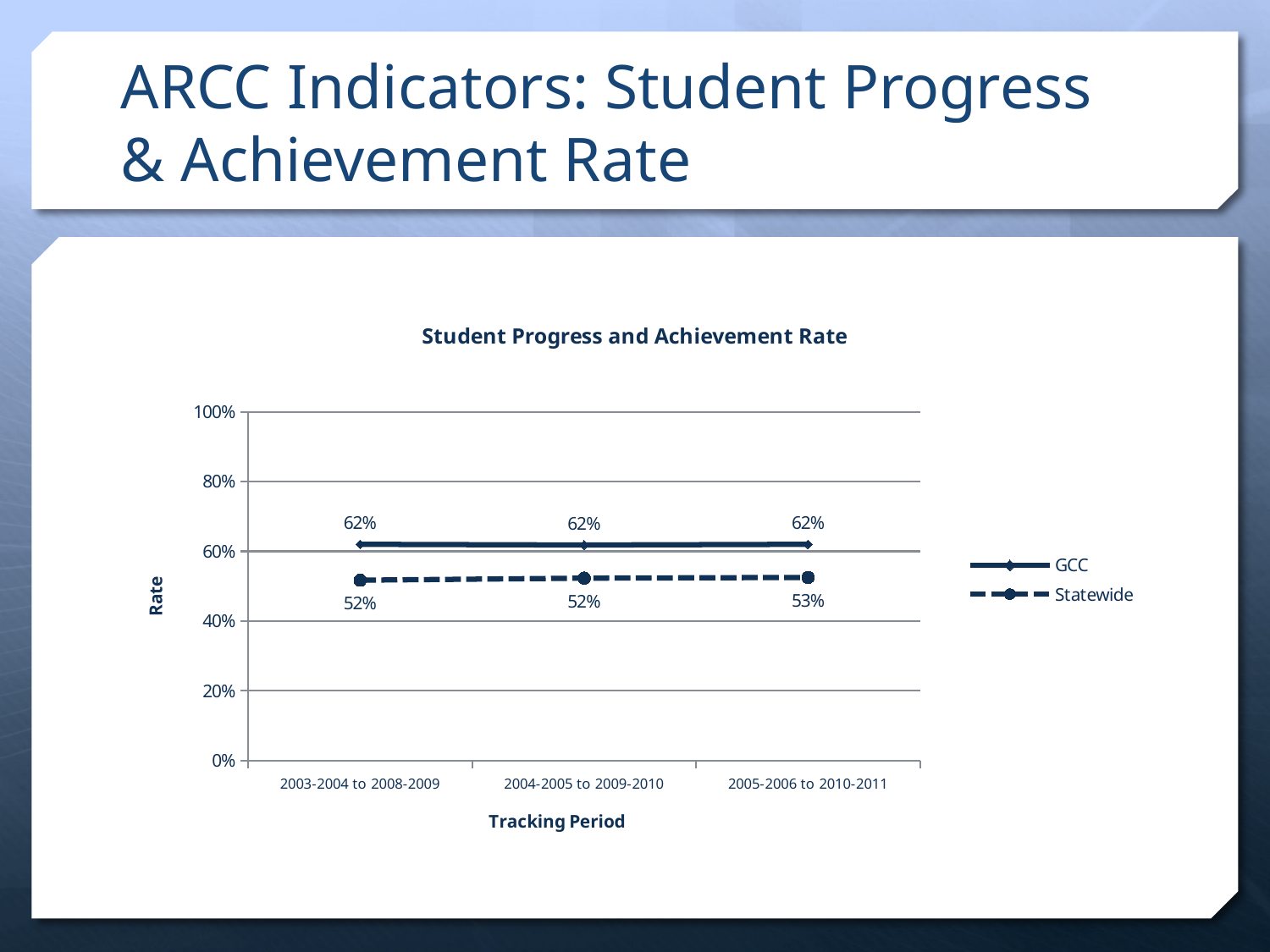
Does the GCC rate rise, fall, or stay flat across the tracking periods? stays flat What is the difference between the GCC and Statewide rates for the 2005-2006 to 2010-2011 tracking period? 9% Is the GCC rate for the 2005-2006 to 2010-2011 tracking period greater or less than 60%? greater How many tracking periods are shown on the x axis? 3 Which is larger for the 2004-2005 to 2009-2010 tracking period, the GCC rate or the Statewide rate? GCC How many series does the legend list? 2 What is the Statewide rate for the 2004-2005 to 2009-2010 tracking period? 52% Which tracking period has the highest Statewide rate? 2005-2006 to 2010-2011 What is the difference between the GCC and Statewide rates for the 2003-2004 to 2008-2009 tracking period? 10% What is the GCC rate for the 2003-2004 to 2008-2009 tracking period? 62% What is the Statewide rate for the 2005-2006 to 2010-2011 tracking period? 53% What kind of chart is shown on the slide? line chart